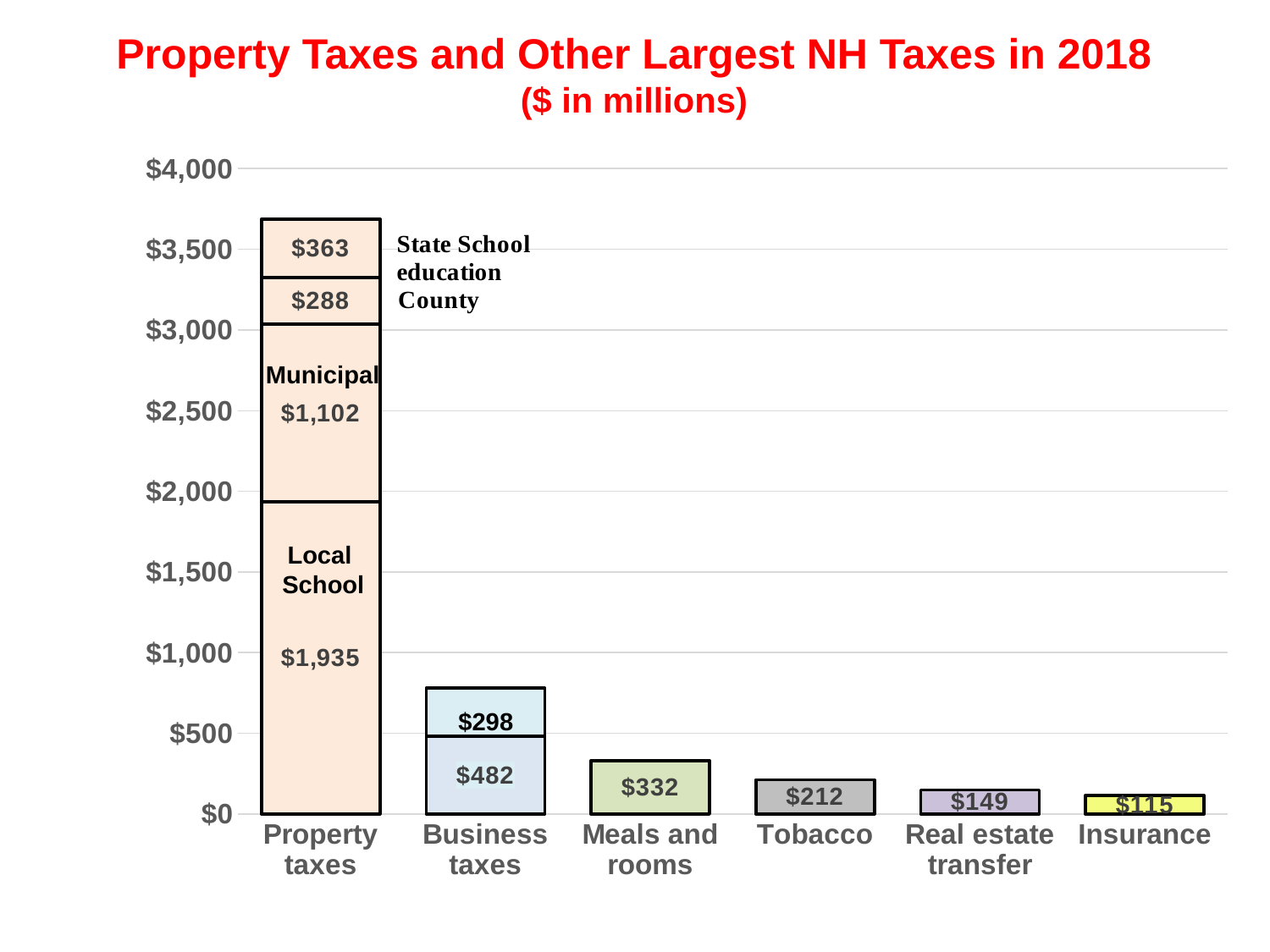
What is the value of the Local School segment of the Property taxes bar? $1,935 What is the value for Meals and rooms? $332 What is the total of the Business taxes bar? $780 What kind of chart is this? Stacked bar chart What is the difference between Meals and rooms and Tobacco? $120 Which is larger, Real estate transfer or Insurance? Real estate transfer Which category has the lowest value? Insurance What is the total of the Property taxes bar? $3,688 Which category has the tallest bar? Property taxes What is the value of the Municipal segment of the Property taxes bar? $1,102 What is the value for Tobacco? $212 How many tax categories are shown on the x axis? 6